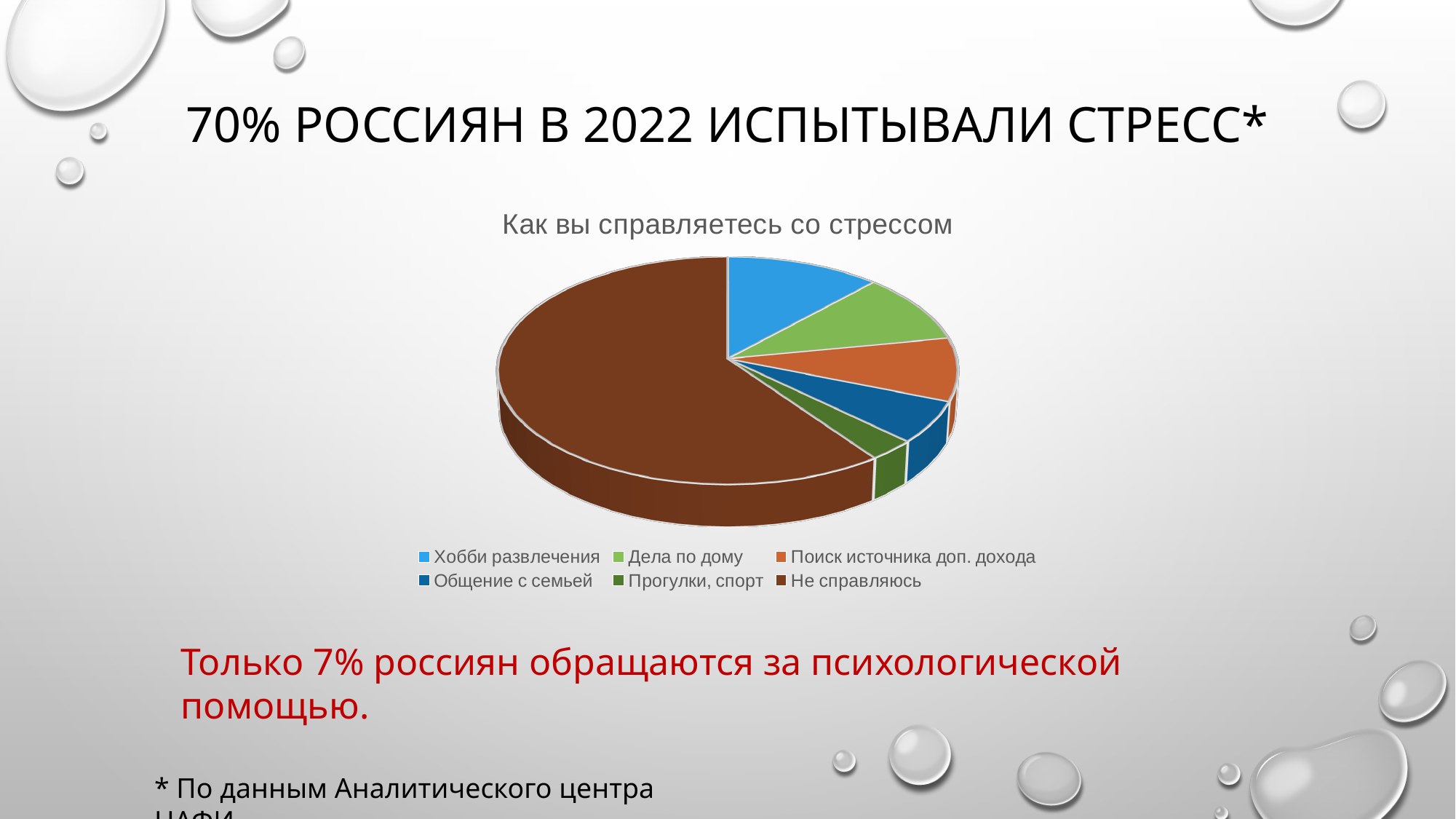
Which category has the largest slice of the pie? Не справляюсь Which is larger, the slice for Хобби развлечения or the slice for Прогулки, спорт? Хобби развлечения How many categories does the pie chart have? 6 Which is larger, the slice for Не справляюсь or the slice for Хобби развлечения? Не справляюсь Which is larger, the slice for Дела по дому or the slice for Прогулки, спорт? Дела по дому What kind of chart is shown on the slide? pie chart What colour is the slice for Не справляюсь? brown What is the title of the chart? Как вы справляетесь со стрессом How many entries does the legend list? 6